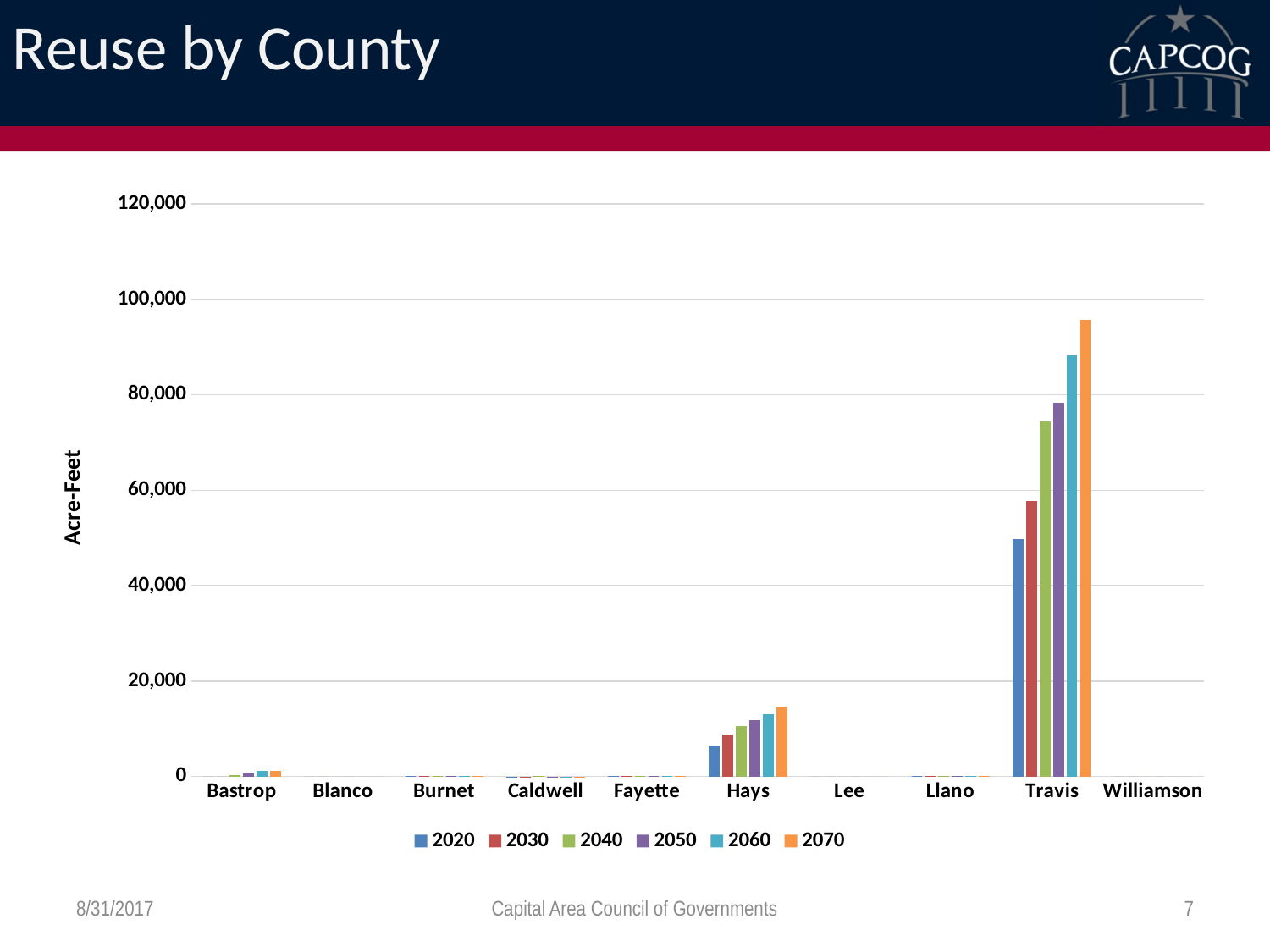
Do the reuse values for Travis rise or fall from 2020 to 2070? rise Is the 2070 value for Travis greater or less than 80,000 acre-feet? greater How many series does the chart legend list? 6 Is the 2020 value for Travis greater or less than 40,000 acre-feet? greater What is the label on the vertical axis of the chart? Acre-Feet Which county has the second-highest reuse values in the chart? Hays Which is larger, the 2070 value for Travis or the 2070 value for Hays? Travis Is the 2070 value for Hays greater or less than 20,000 acre-feet? less What kind of chart is shown on the slide? bar chart How many counties are shown on the x axis of the chart? 10 Which county has the highest reuse values in the chart? Travis